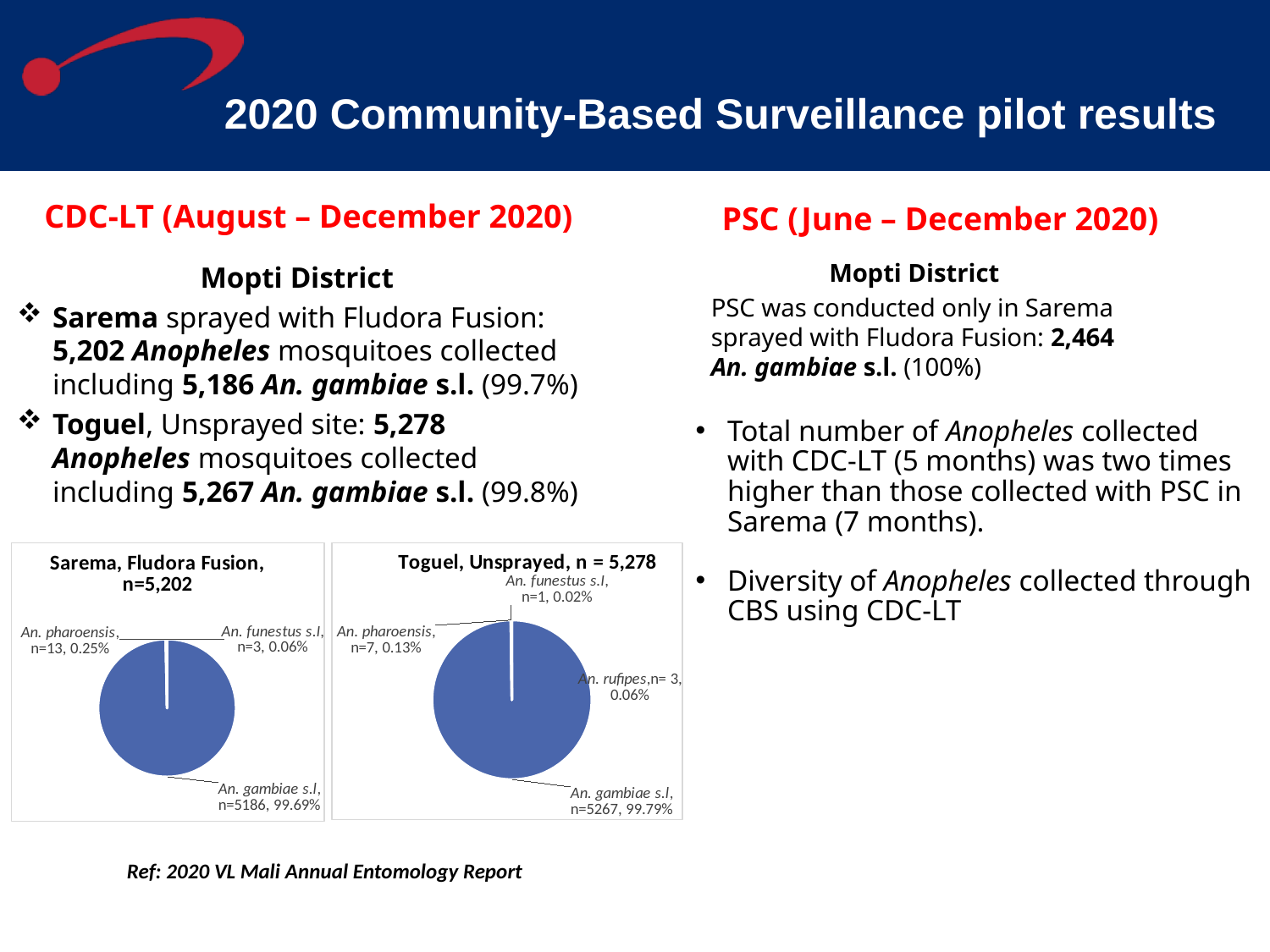
In the Sarema, Fludora Fusion pie chart, how many species slices are shown? 3 In the Sarema, Fludora Fusion pie chart, what is the value for An. funestus s.l? n=3 In the Toguel, Unsprayed pie chart, which species has the smallest slice? An. funestus s.l In the Sarema, Fludora Fusion pie chart, how many An. gambiae s.l were collected? n=5186 In the Toguel, Unsprayed pie chart, which is larger, An. pharoensis or An. funestus s.l? An. pharoensis In the Toguel, Unsprayed pie chart, how many species slices are shown? 4 What type of chart is used for the Sarema, Fludora Fusion data? Pie chart In the Toguel, Unsprayed pie chart, how many An. gambiae s.l were collected? n=5267 In the Sarema, Fludora Fusion pie chart, what share of the pie is An. pharoensis? 0.25% In the Sarema, Fludora Fusion pie chart, which species has the smallest slice? An. funestus s.l In the Toguel, Unsprayed pie chart, what is the difference in count between An. pharoensis and An. rufipes? 4 In the Toguel, Unsprayed pie chart, what share of the pie is An. rufipes? 0.06%